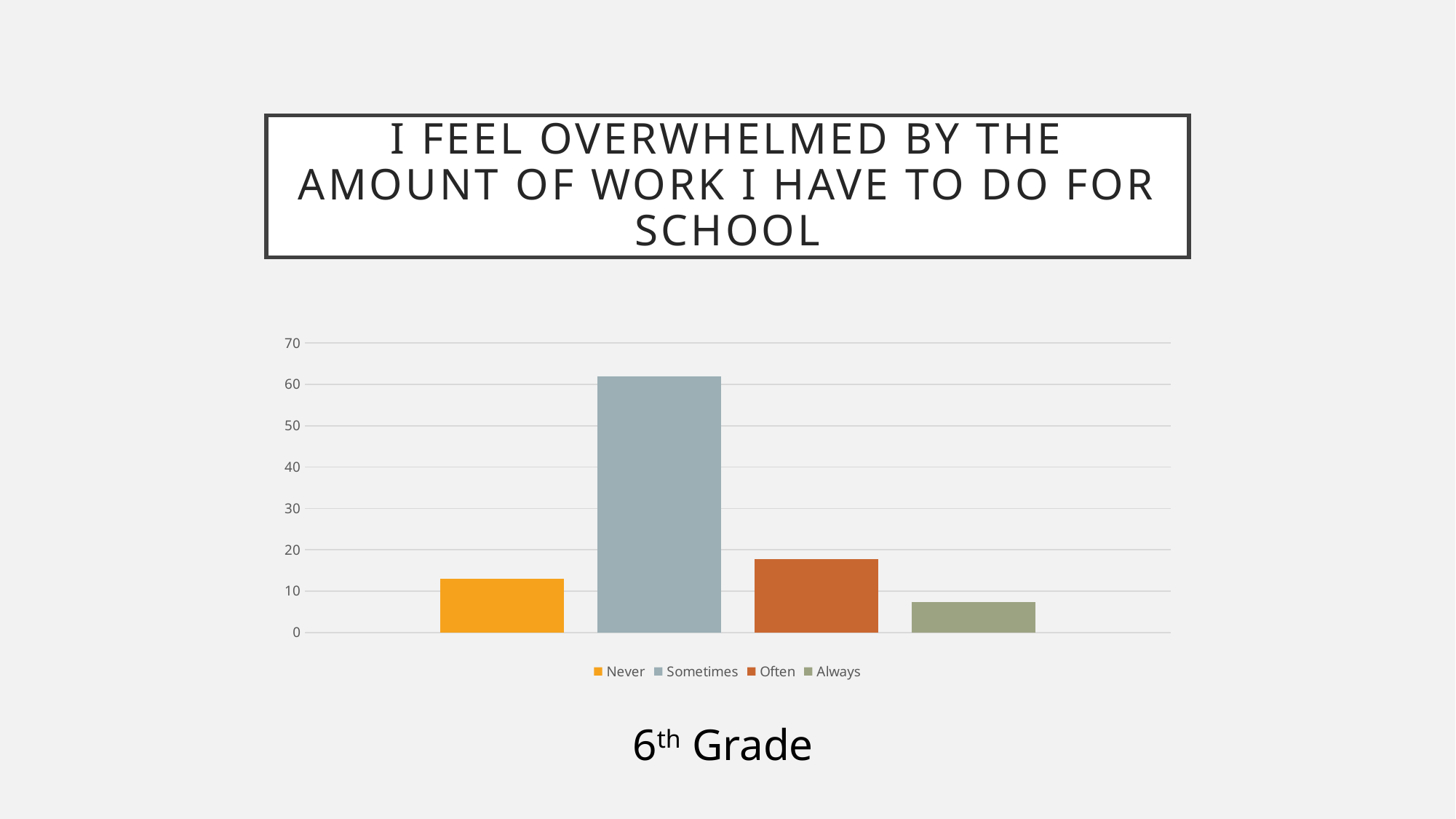
Is the value for Always greater or less than 10? less How many entries does the chart's legend list? 4 Which is larger, the value for Often or the value for Never? Often Is the value for Sometimes greater or less than 50? greater Is the value for Never greater or less than 20? less Which response category has the highest bar? Sometimes How many bars are plotted in the chart? 4 What kind of chart is shown on the slide? bar chart Which grade does the chart on the slide refer to? 6th Grade Which response category has the lowest bar? Always